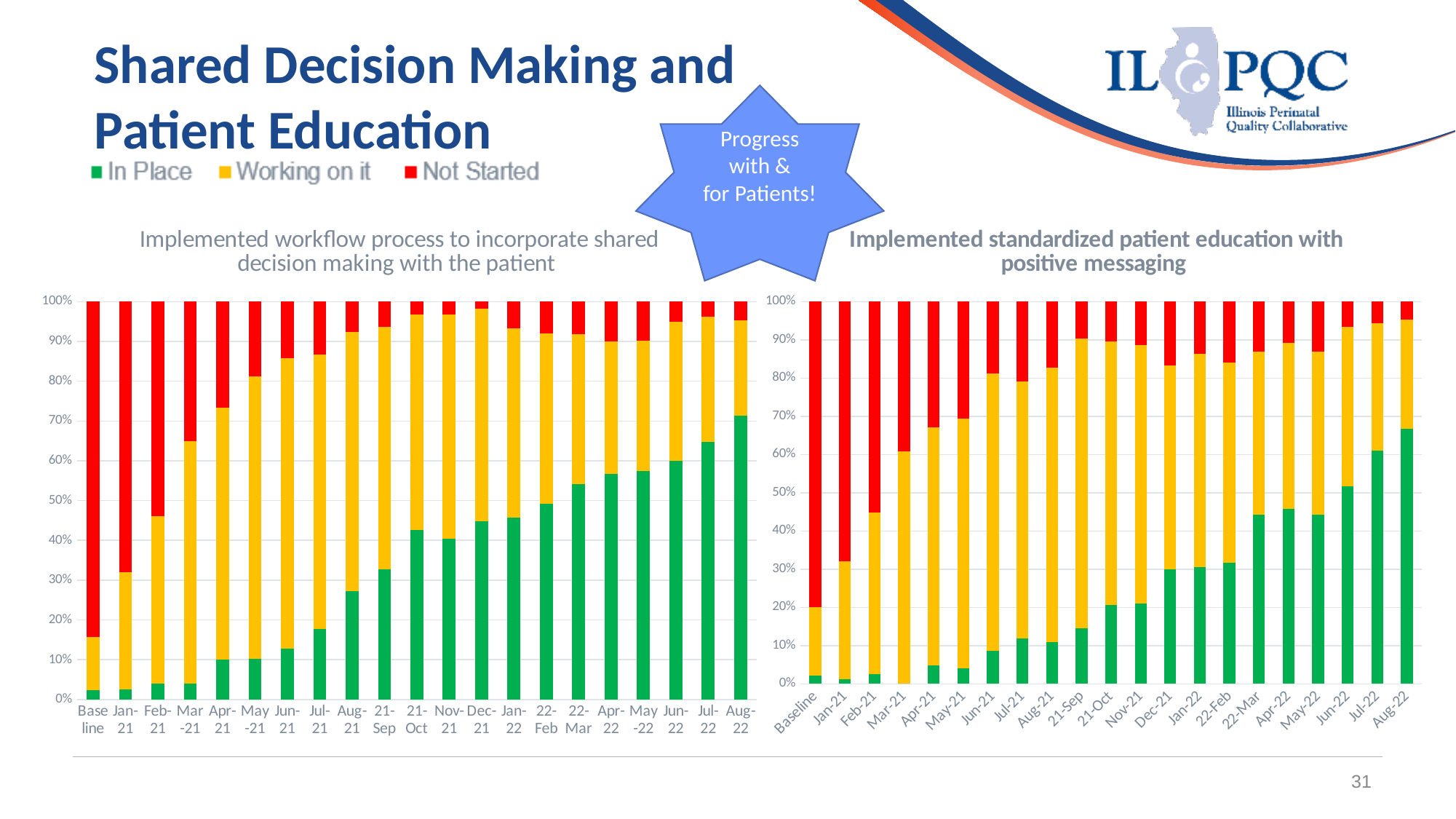
In the right chart, is the 'In Place' share for Baseline greater or less than 10%? less In the left chart, how many time-period categories are plotted along the x axis? 21 How many series does the legend list for the charts on this slide? 3 What kind of chart is the left chart, 'Implemented workflow process to incorporate shared decision making with the patient'? Stacked bar chart In the left chart, does the 'In Place' share rise or fall from Baseline to Aug-22? Rises In the right chart, 'Implemented standardized patient education with positive messaging', how many bars are plotted? 21 In the right chart, does the 'Not Started' share rise or fall from Baseline to Aug-22? Falls In the right chart, which period has the lowest 'In Place' share? Mar-21 In the left chart, which is larger: the 'In Place' share for Jul-22 or for Jan-22? Jul-22 In the left chart, is the 'In Place' share for Aug-22 greater or less than 70%? greater In the left chart, which period has the highest 'In Place' share? Aug-22 Which colour represents 'Working on it' in the charts? Yellow